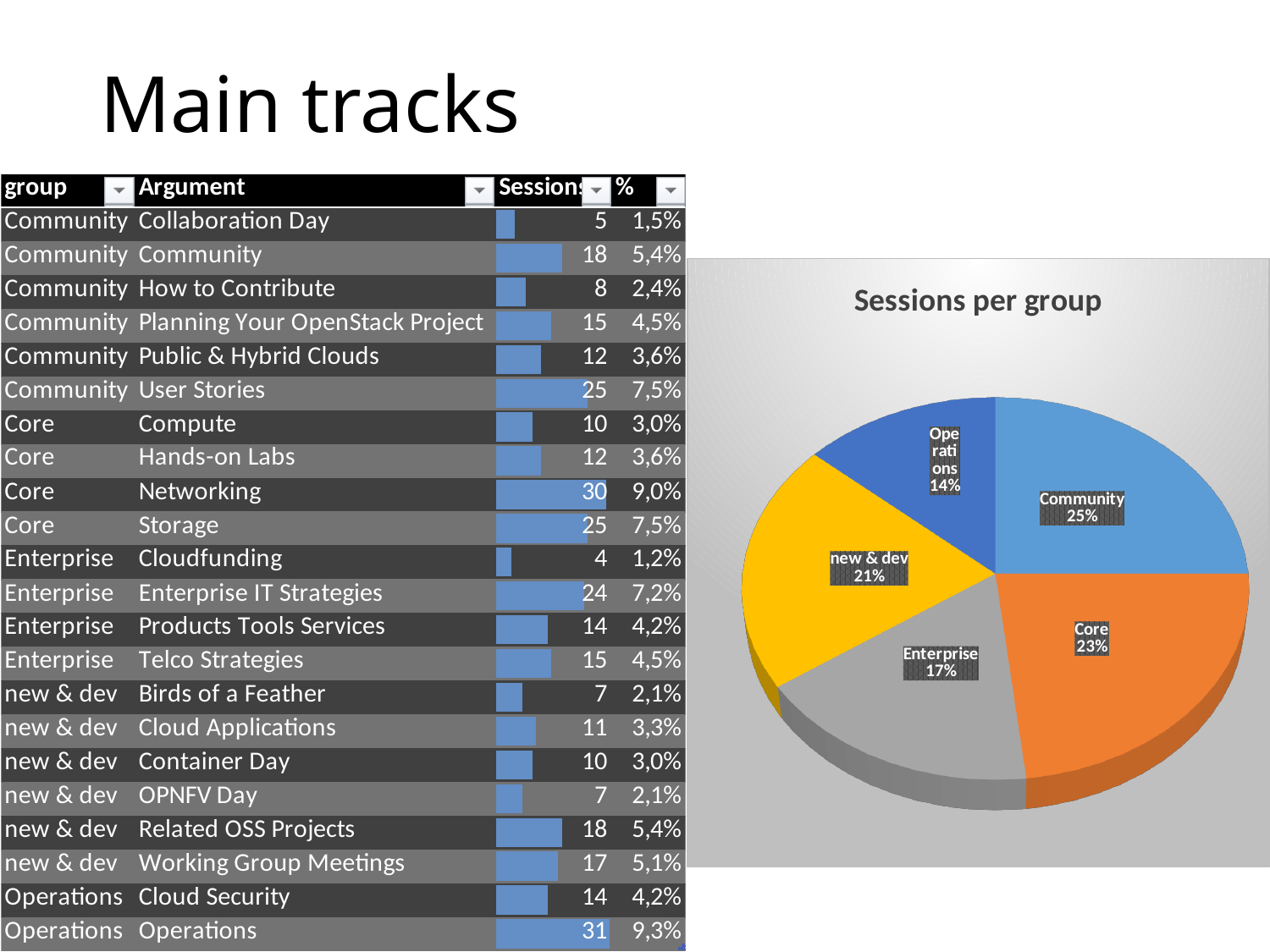
What is the title of the pie chart? Sessions per group Which group has the largest slice in the "Sessions per group" pie chart? Community In the "Sessions per group" pie chart, which is larger, Core or Enterprise? Core Which group has the smallest slice in the "Sessions per group" pie chart? Operations In the "Sessions per group" pie chart, what share does Operations have? 14% In the "Sessions per group" pie chart, what share does Community have? 25% In the "Sessions per group" pie chart, what share does Core have? 23% How many slices does the "Sessions per group" pie chart have? 5 What kind of chart is the "Sessions per group" chart? pie chart In the "Sessions per group" pie chart, what is the difference in percentage points between Community and Operations? 11